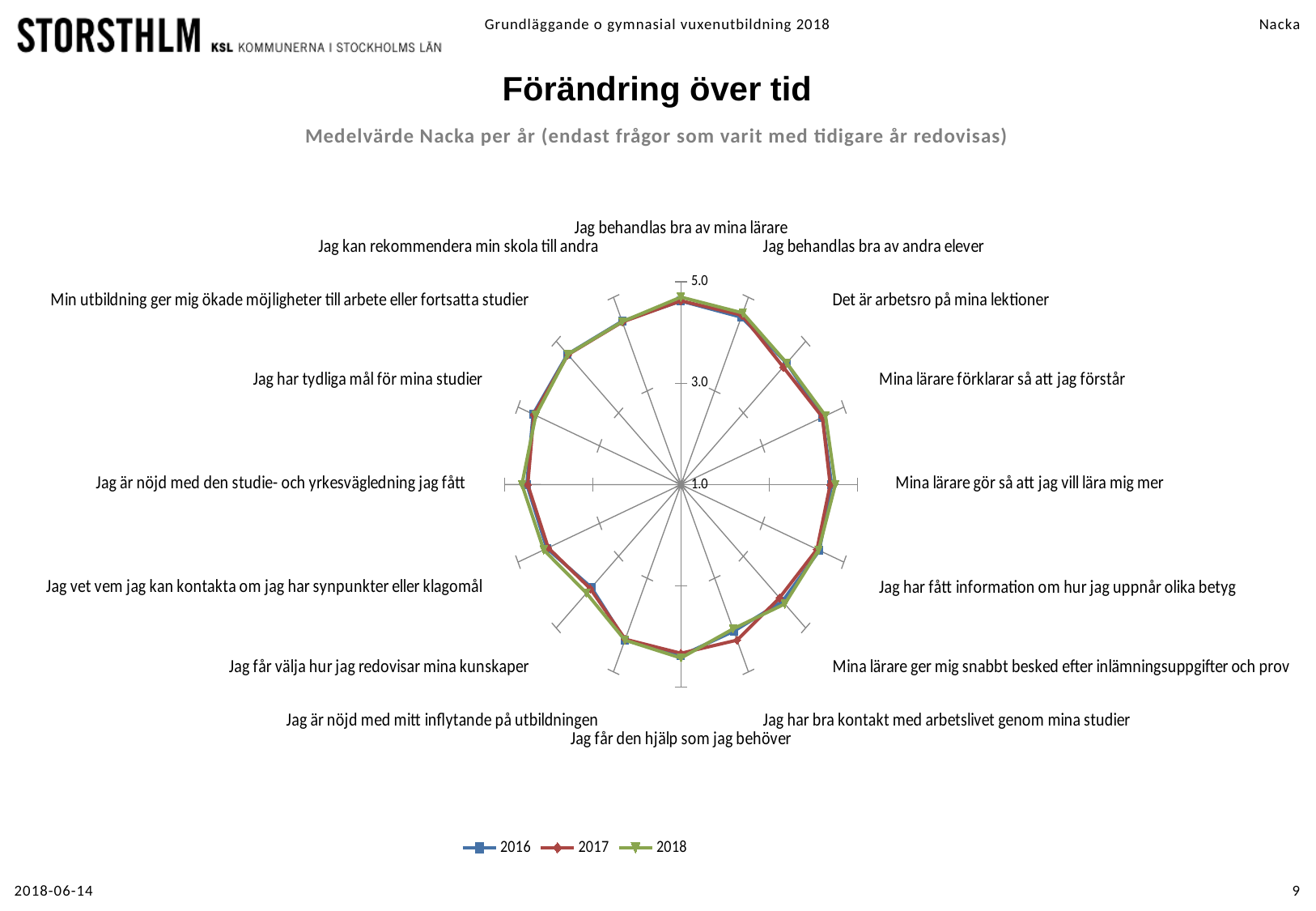
Is the 2018 value for "Jag behandlas bra av mina lärare" greater or less than 3.0? greater What is the title of the chart? Förändring över tid What kind of chart is shown on the slide? Radar chart Is the 2017 value for "Jag har bra kontakt med arbetslivet genom mina studier" greater or less than 3.0? greater How many series does the legend list? 3 Is the 2018 value for "Jag behandlas bra av andra elever" greater or less than 1.0? greater How many categories (questions) are plotted around the radar chart? 16 Which years are listed in the legend? 2016, 2017, 2018